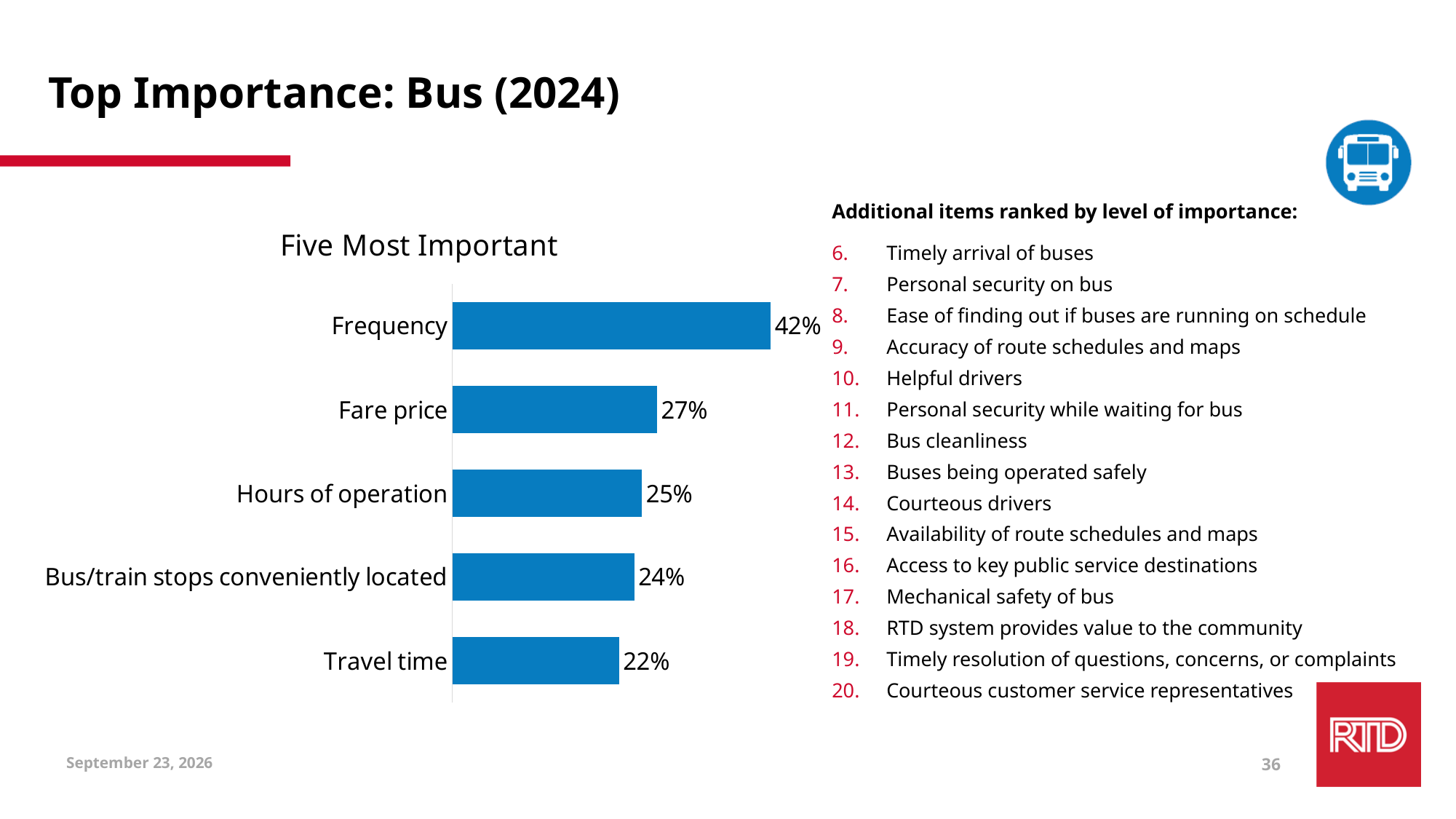
What is the value for Travel time? 22% What is the value for Frequency? 42% What is the difference between the values for Frequency and Fare price? 15% Which category has the highest value? Frequency What is the title of the chart? Five Most Important How many categories are shown in the chart? 5 Which category has the lowest value? Travel time What kind of chart is shown on the slide? Bar chart Which is larger, the value for Fare price or the value for Hours of operation? Fare price What is the difference between the values for Bus/train stops conveniently located and Travel time? 2% What is the value for Hours of operation? 25% What is the value for Fare price? 27%